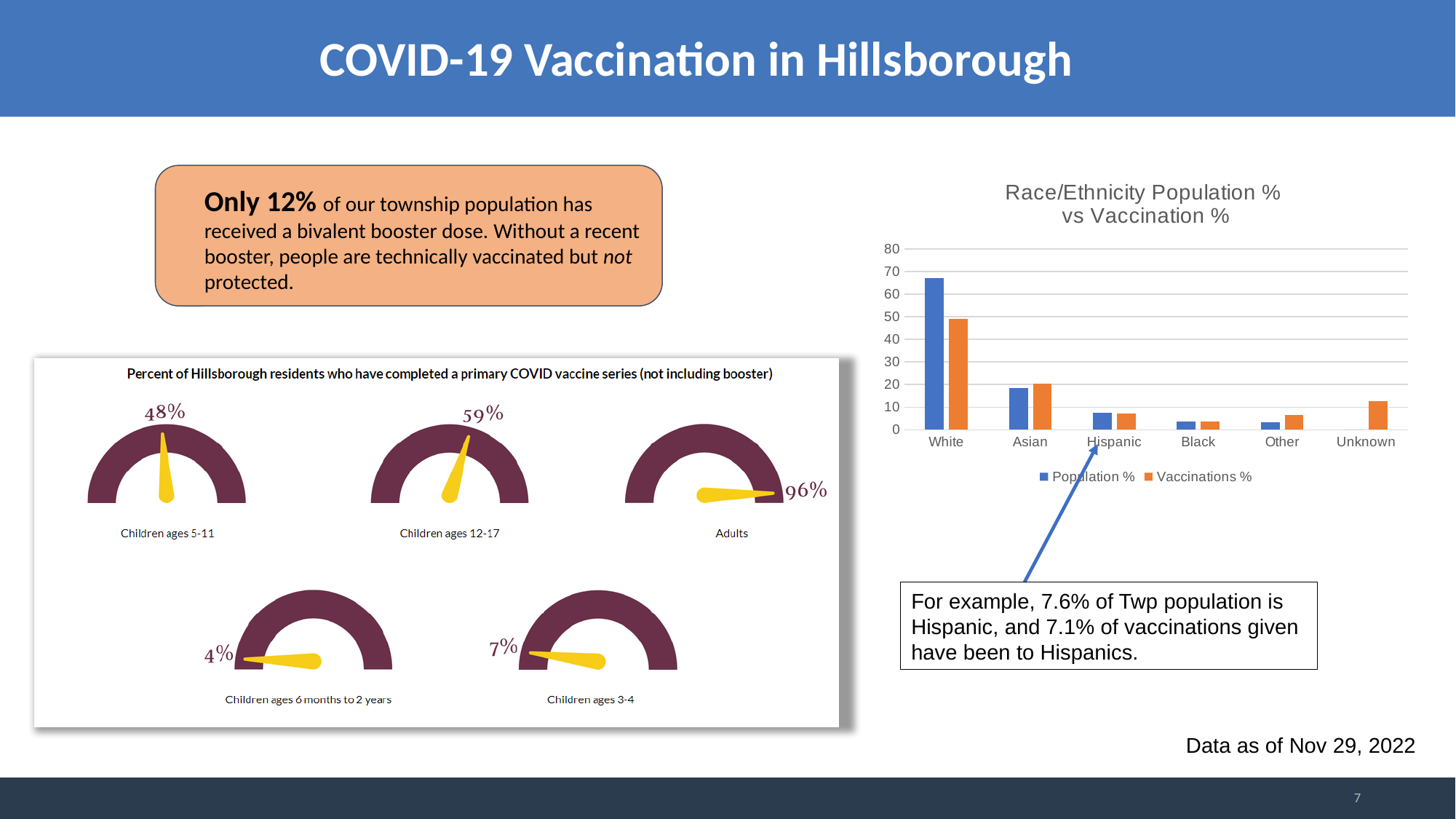
In the 'Race/Ethnicity Population % vs Vaccination %' chart, how many race/ethnicity categories are shown on the x axis? 6 In the 'Race/Ethnicity Population % vs Vaccination %' chart, is the Vaccinations % value for Unknown greater or less than 10? greater How many series does the legend of the 'Race/Ethnicity Population % vs Vaccination %' chart list? 2 In the 'Race/Ethnicity Population % vs Vaccination %' chart, which is larger for White: Population % or Vaccinations %? Population % What kind of chart is the 'Race/Ethnicity Population % vs Vaccination %' chart? Bar chart In the gauge chart on the left, which group has the highest percentage? Adults How many age groups are shown in the gauge chart on the left? 5 In the gauge chart on the left, what percent of Adults have completed a primary COVID vaccine series? 96% In the gauge chart on the left, what is the value shown for Children ages 12-17? 59% In the 'Race/Ethnicity Population % vs Vaccination %' chart, is the Population % value for White greater or less than 60? greater In the gauge chart on the left, which group has the lowest percentage? Children ages 6 months to 2 years In the gauge chart on the left, what is the difference between the values for Children ages 12-17 and Children ages 5-11? 11 percentage points